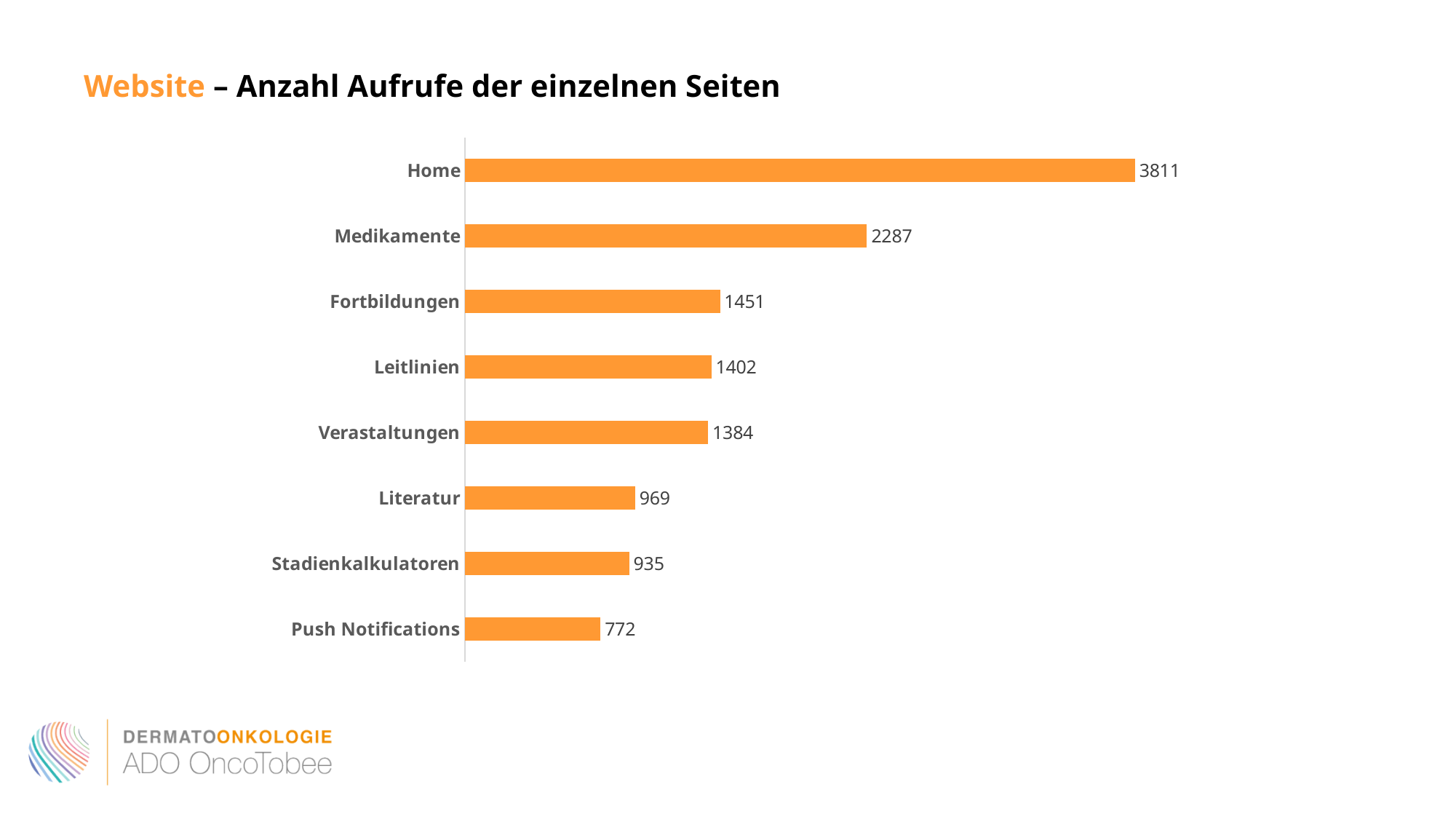
Which has more views, Fortbildungen or Literatur? Fortbildungen How many pages (categories) are shown in the chart? 8 What kind of chart is shown on the slide? Bar chart What is the value shown for Medikamente? 2287 What is the title of the slide? Website – Anzahl Aufrufe der einzelnen Seiten What is the value shown for Push Notifications? 772 What is the value shown for Leitlinien? 1402 What is the difference between the values for Literatur and Stadienkalkulatoren? 34 How many page views does the Home page have? 3811 Which page has the lowest number of views? Push Notifications Which page has the highest number of views? Home What is the difference between the values for Home and Medikamente? 1524